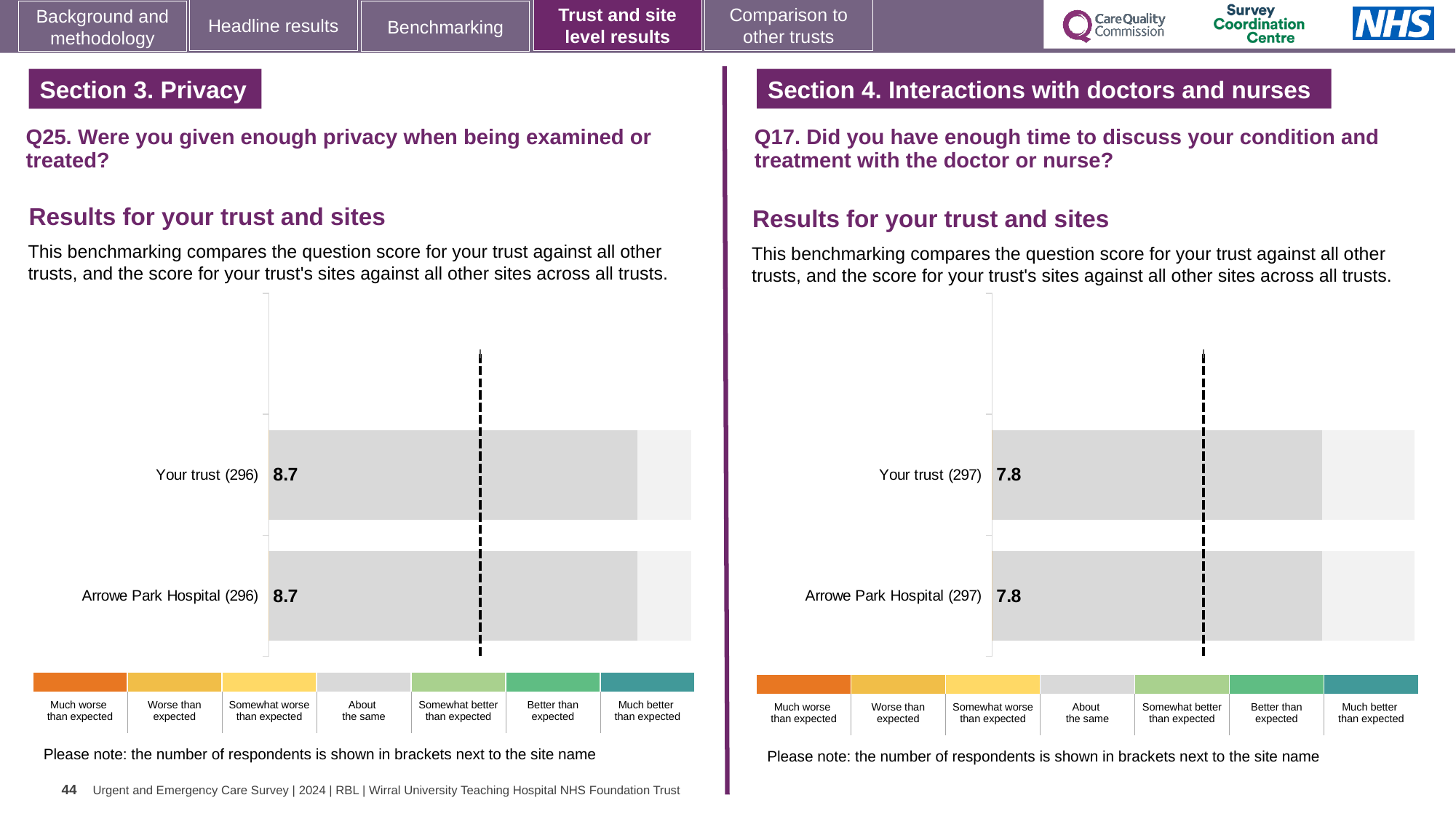
What is the difference between the Your trust score in the Q25 chart on the left and the Your trust score in the Q17 chart on the right? 0.9 In the Q17 chart on the right, what is the score for Your trust? 7.8 How many bars are plotted in the Q17 chart on the right? 2 In the Q17 chart on the right, what is the score for Arrowe Park Hospital? 7.8 How many rating categories does the colour key below the Q25 chart on the left list? 7 In the Q17 chart on the right, how many respondents are shown in brackets for Your trust? 297 What kind of chart is used in the Q25 privacy chart on the left? Bar chart In the Q25 privacy chart on the left, how many respondents are shown in brackets for Arrowe Park Hospital? 296 In the Q25 privacy chart on the left, what is the difference between the Your trust score and the Arrowe Park Hospital score? 0 In the colour key below the Q17 chart on the right, what colour represents 'Much worse than expected'? Orange In the Q25 privacy chart on the left, what is the score for Your trust? 8.7 In the Q25 privacy chart on the left, what is the score for Arrowe Park Hospital? 8.7